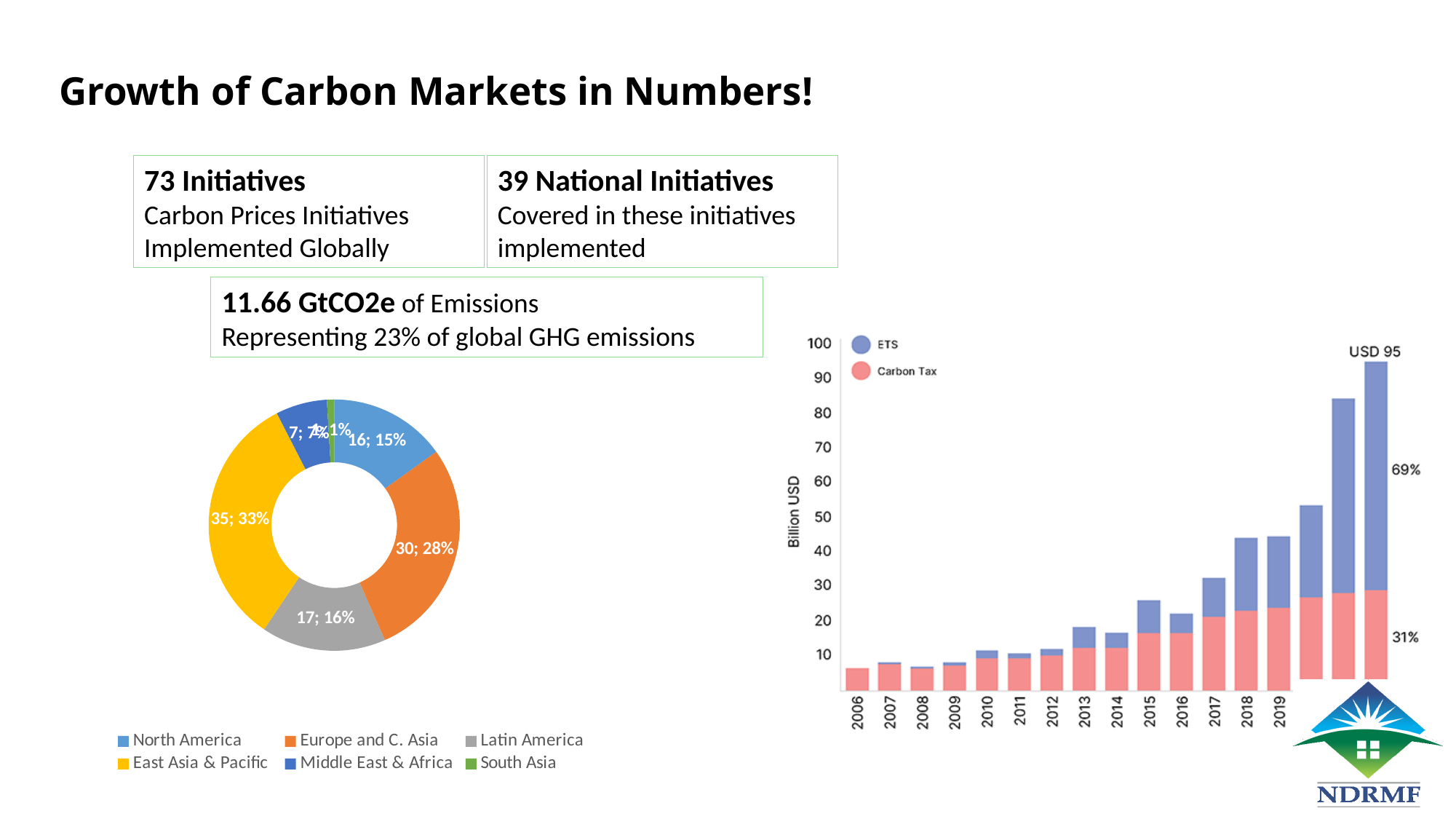
In the doughnut chart on the left, which region has the largest share? East Asia & Pacific In the doughnut chart on the left, what is the count shown for East Asia & Pacific? 35 In the bar chart on the right, what percentage of the tallest bar is labelled as ETS? 69% In the bar chart on the right, do the total values generally rise or fall from 2006 onward? Rise How many series does the legend of the bar chart on the right list? 2 In the doughnut chart on the left, what percentage share is shown for Europe and C. Asia? 28% In the doughnut chart on the left, which region has the smallest share? South Asia How many regions are shown in the doughnut chart on the left? 6 What kind of chart is the chart on the right showing Billion USD by year? Stacked bar chart In the bar chart on the right, what value is labelled on the tallest bar? USD 95 In the bar chart on the right, is the total value for 2015 greater or less than 20? greater In the doughnut chart on the left, what is the difference between the counts for Europe and C. Asia and Latin America? 13